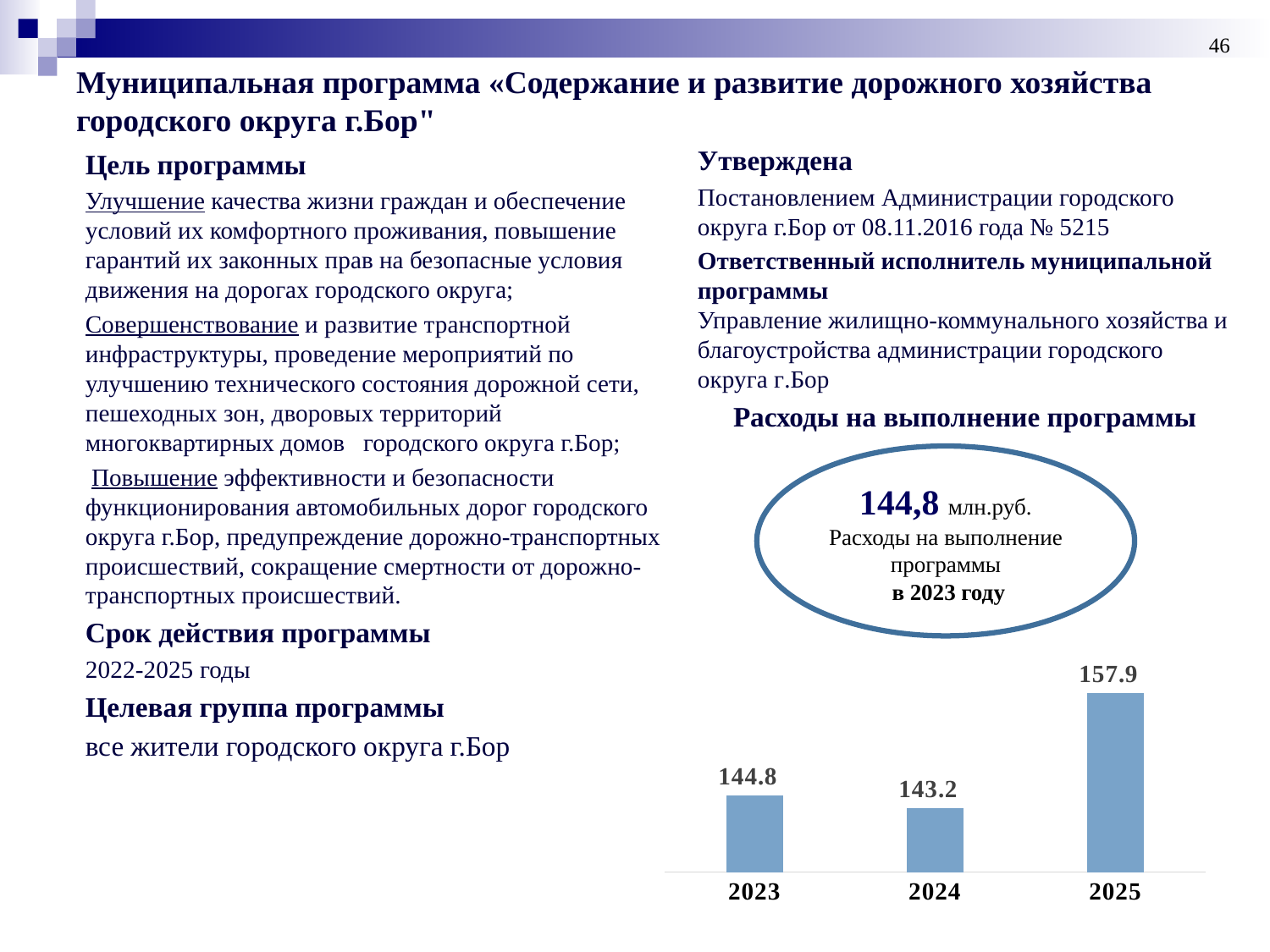
Does the value rise or fall from 2024 to 2025? rise Which is larger, the value for 2025 or the value for 2024? 2025 What is the value for 2023 in the chart? 144.8 What kind of chart is shown on the slide? bar chart What is the difference between the values for 2023 and 2024? 1.6 What is the value for 2024 in the chart? 143.2 What is the difference between the values for 2025 and 2023? 13.1 How many years are shown in the chart? 3 What is the title of the chart? Расходы на выполнение программы Which year has the lowest value in the chart? 2024 What is the value for 2025 in the chart? 157.9 Which year has the highest value in the chart? 2025